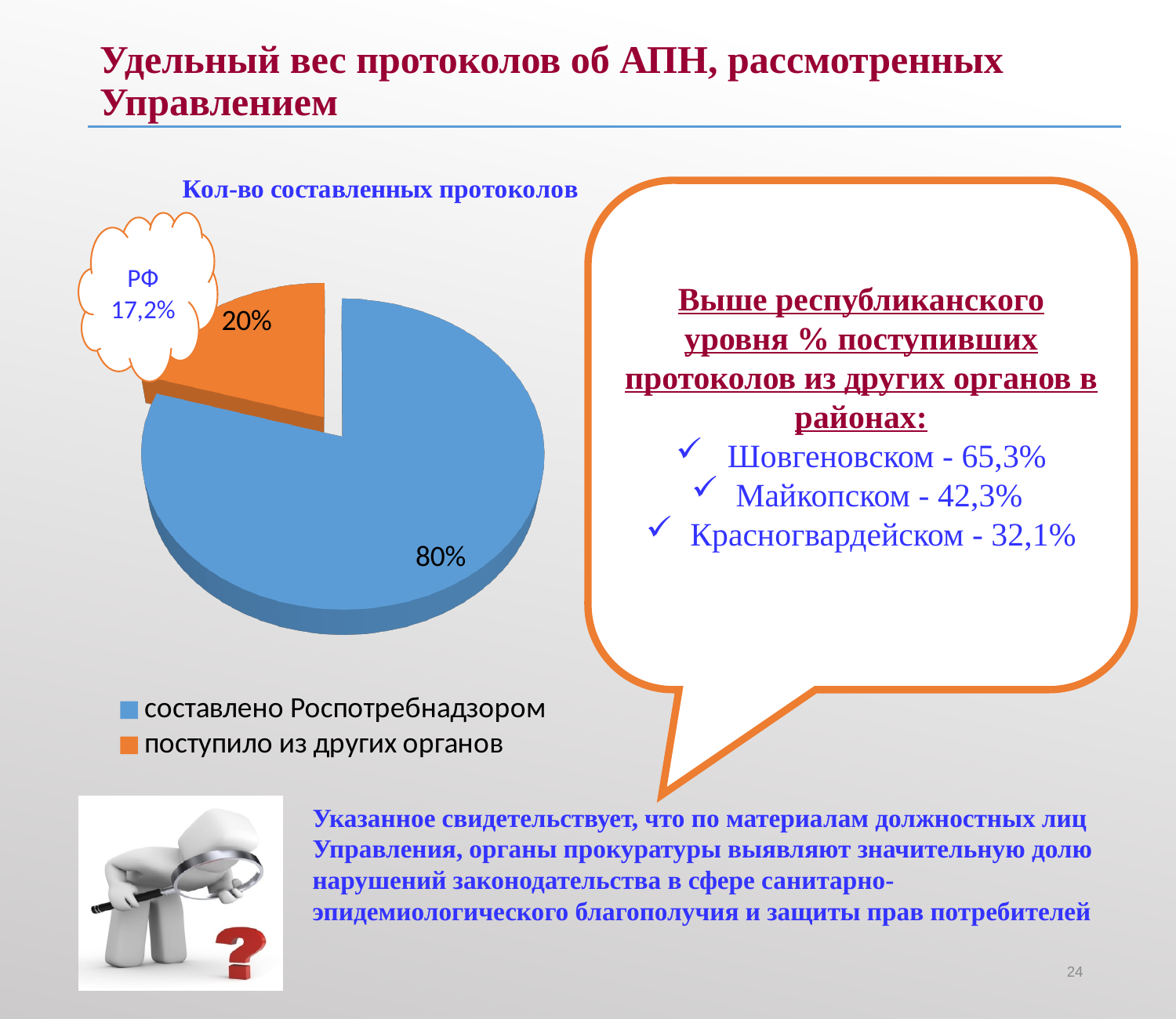
What colour is the slice for "поступило из других органов"? orange How many slices does the pie chart have? 2 Which is larger: the slice for "составлено Роспотребнадзором" or the slice for "поступило из других органов"? составлено Роспотребнадзором What share of the pie is labelled "поступило из других органов"? 20% What is the total of the two slices shown in the pie chart? 100% What kind of chart is shown on the slide? pie chart What is the difference in percentage points between the two slices of the pie? 60 Which category has the smallest slice of the pie? поступило из других органов Which category has the largest slice of the pie? составлено Роспотребнадзором What share of the pie is labelled "составлено Роспотребнадзором"? 80% What is the title of the chart? Кол-во составленных протоколов How many entries does the chart legend list? 2